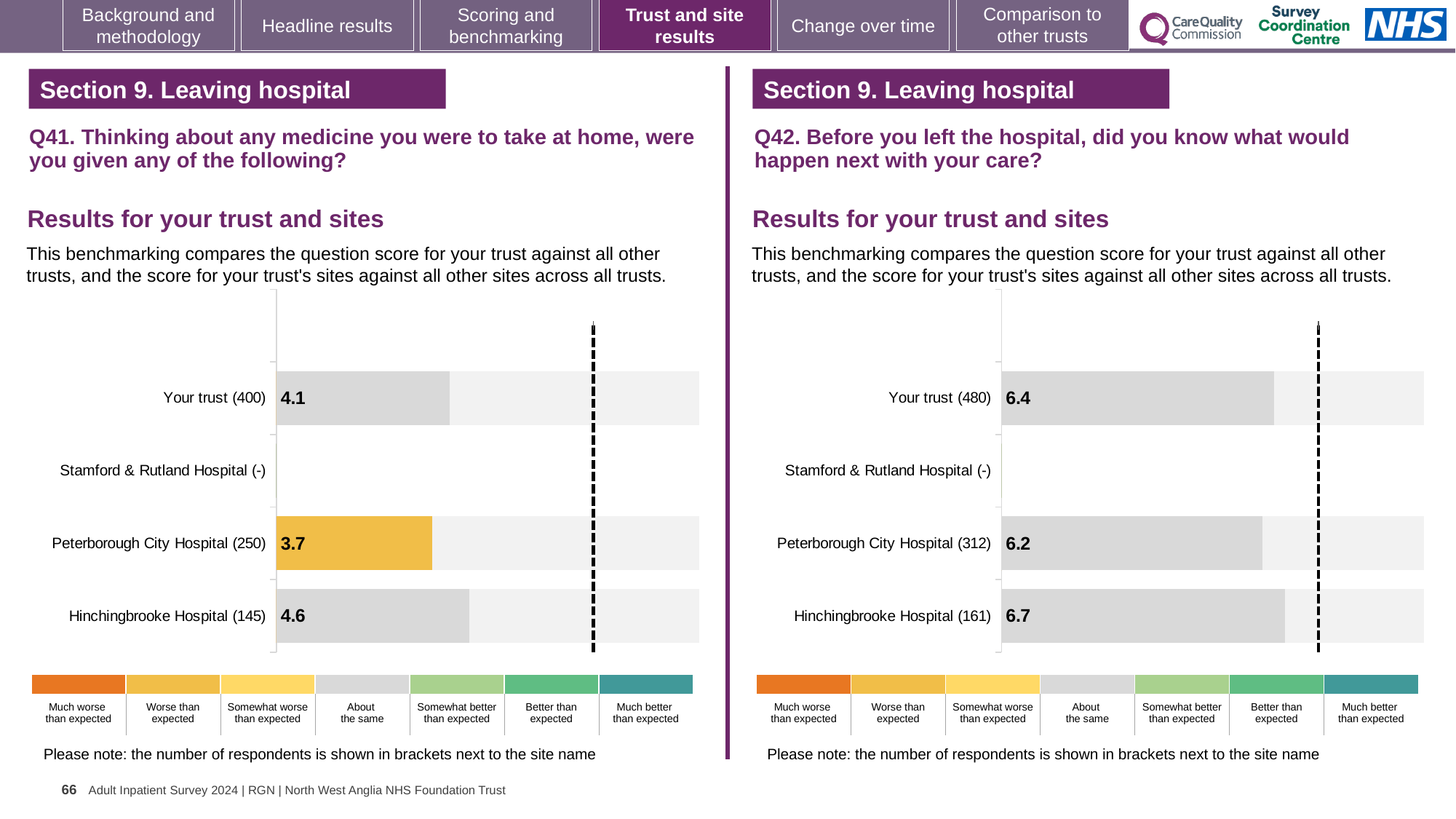
In the Q41 chart on the left, what is the difference between the scores for Hinchingbrooke Hospital and Peterborough City Hospital? 0.9 In the Q41 chart on the left, which site has the highest score? Hinchingbrooke Hospital In the Q42 chart on the right, what is the score for Your trust? 6.4 In the Q41 chart on the left, what is the score for Your trust? 4.1 In the Q42 chart on the right, which site has the lowest score among those with a value shown? Peterborough City Hospital What kind of chart is used for the Q42 results on the right? Bar chart In the Q42 chart on the right, is the score for Your trust larger or smaller than the score for Peterborough City Hospital? larger How many rows (categories) are listed in the Q41 chart on the left? 4 In the Q42 chart on the right, what is the score for Hinchingbrooke Hospital? 6.7 In the Q41 chart on the left, which bar is coloured orange-yellow rather than grey? Peterborough City Hospital In the Q42 chart on the right, what is the difference between the scores for Hinchingbrooke Hospital and Your trust? 0.3 In the Q41 chart on the left, what is the score for Peterborough City Hospital? 3.7